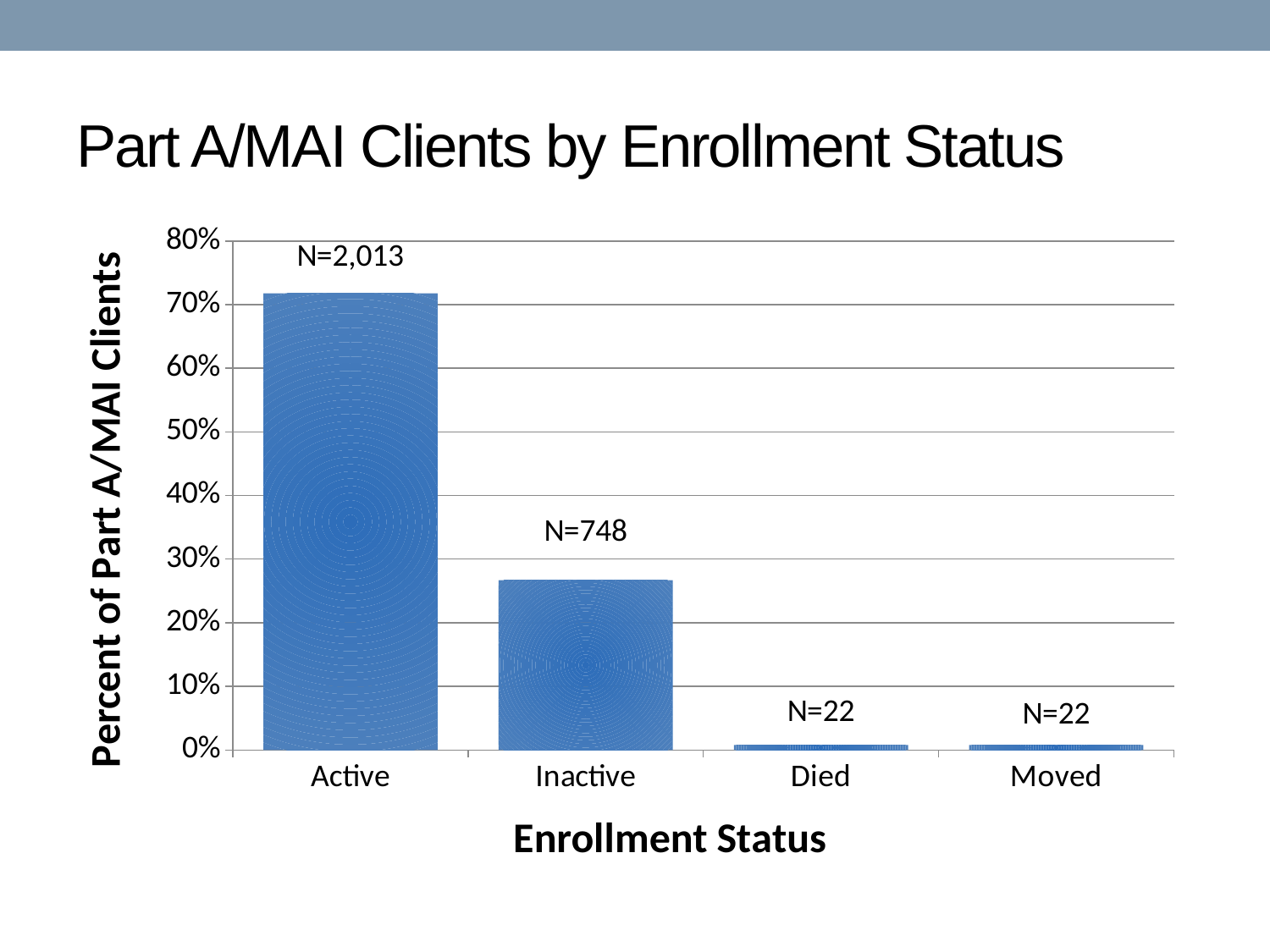
Is the value for Active greater or less than 70%? greater Is the value for Inactive greater or less than 30%? less What is the data label shown above the Active bar? N=2,013 Which is larger, the value for Active or the value for Inactive? Active Which enrollment status has the highest percentage of Part A/MAI clients? Active What is the data label shown above the Died bar? N=22 What is the label of the x axis? Enrollment Status How many enrollment status categories are shown on the x axis? 4 What is the data label shown above the Inactive bar? N=748 What is the label of the y axis? Percent of Part A/MAI Clients Is the value for Died greater or less than 10%? less What kind of chart is shown on the slide? Bar chart